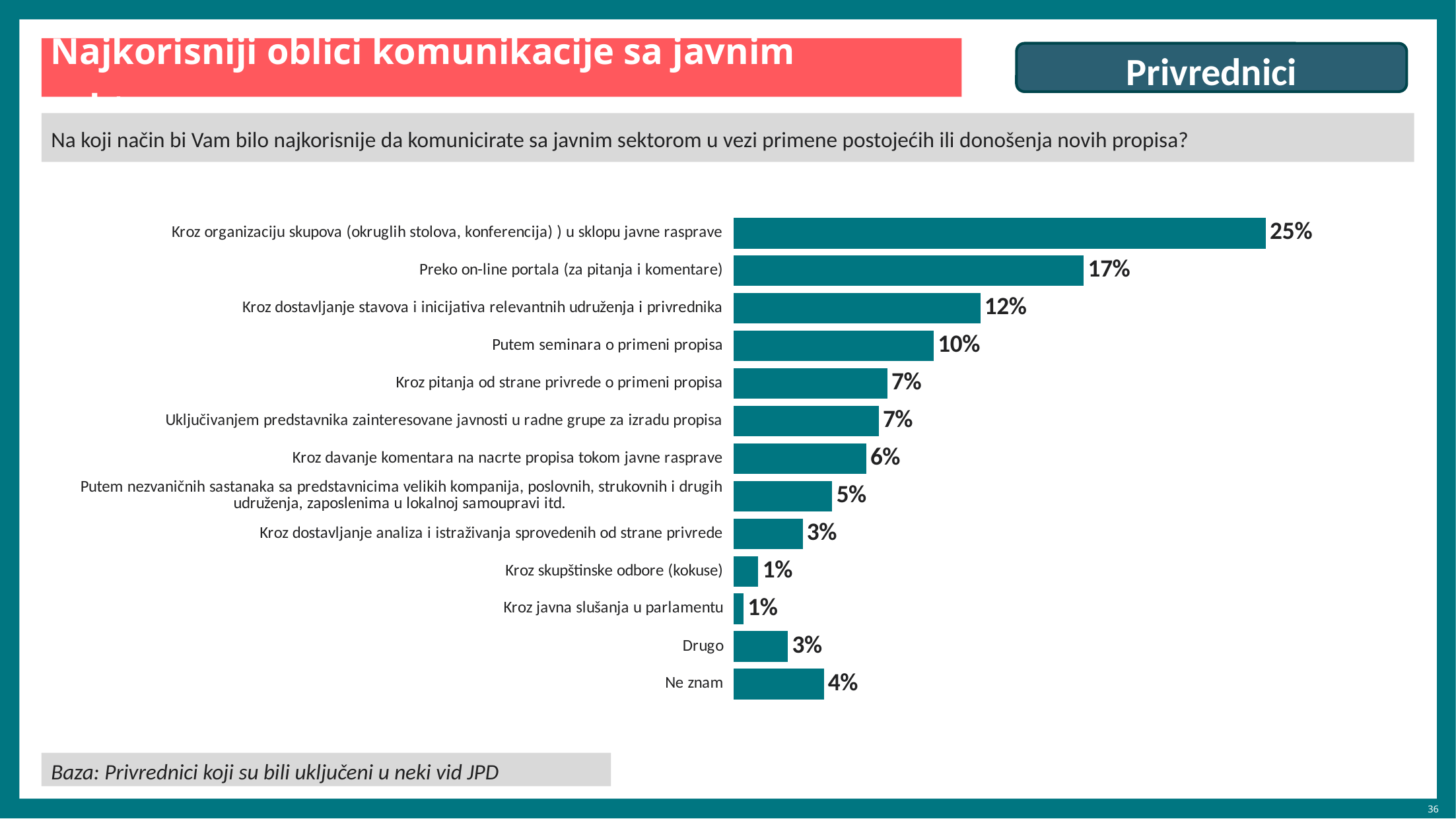
Which category has the highest value? Kroz organizaciju skupova (okruglih stolova, konferencija) ) u sklopu javne rasprave What is the value for "Kroz skupštinske odbore (kokuse)"? 1% What is the difference between the values for "Kroz organizaciju skupova (okruglih stolova, konferencija) ) u sklopu javne rasprave" and "Preko on-line portala (za pitanja i komentare)"? 8% What is the value for "Putem seminara o primeni propisa"? 10% What kind of chart is shown on the slide? bar chart How many categories are plotted in the chart? 13 What is the base (Baza) stated below the chart? Privrednici koji su bili uključeni u neki vid JPD What is the value for "Preko on-line portala (za pitanja i komentare)"? 17% Which is larger: the value for "Kroz dostavljanje stavova i inicijativa relevantnih udruženja i privrednika" or the value for "Putem seminara o primeni propisa"? Kroz dostavljanje stavova i inicijativa relevantnih udruženja i privrednika What is the lowest value shown in the chart? 1% What is the value for "Ne znam"? 4% What is the value for "Kroz davanje komentara na nacrte propisa tokom javne rasprave"? 6%